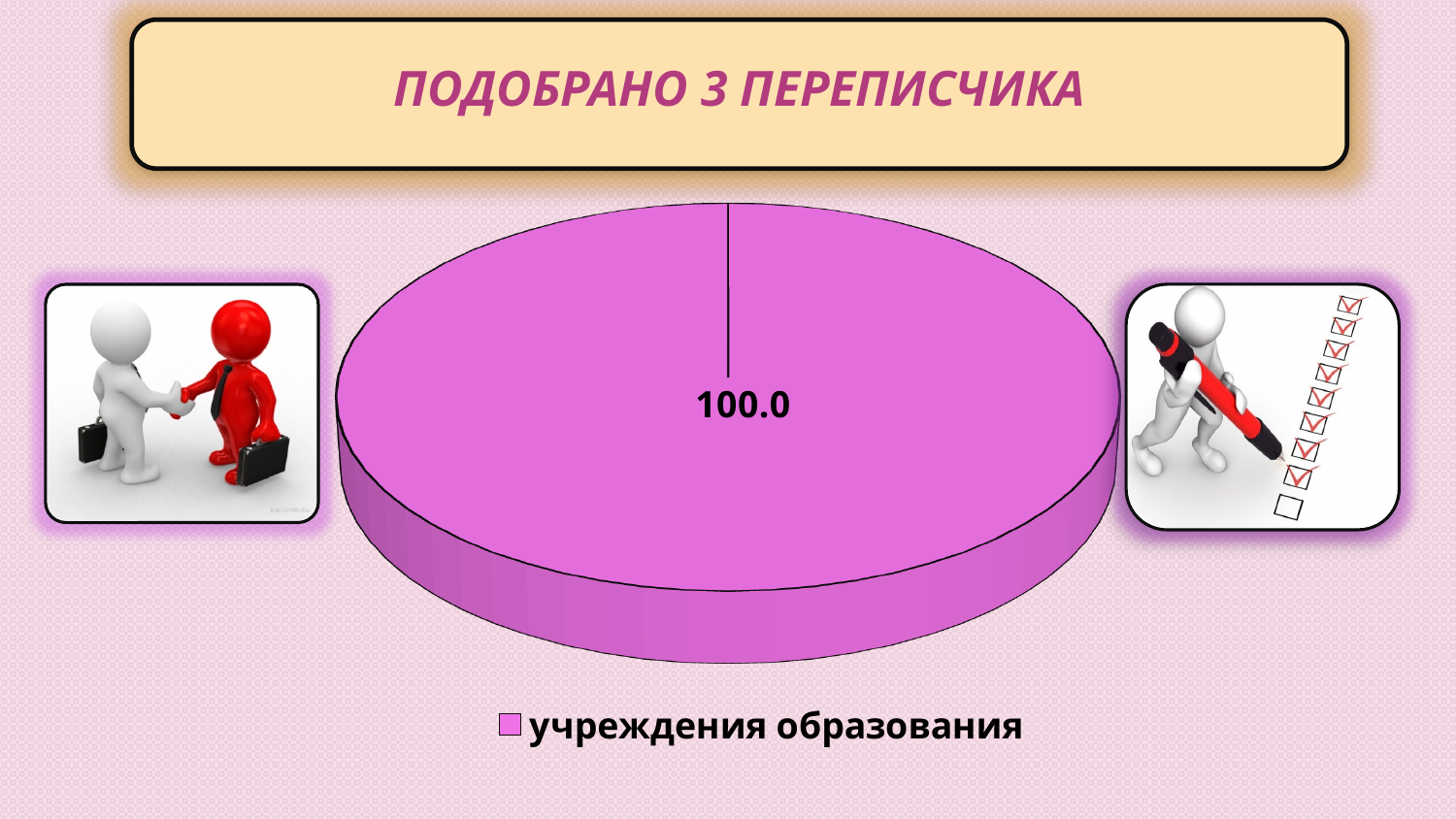
Is the value for учреждения образования greater or less than 50? greater How many entries does the legend list? 1 What is the legend entry of the pie chart? учреждения образования What colour is the pie slice for учреждения образования? pink What is the value for учреждения образования? 100.0 What kind of chart is shown on the slide? pie chart What share of the pie does учреждения образования take? 100.0 How many slices does the pie chart have? 1 What value is printed on the pie slice? 100.0